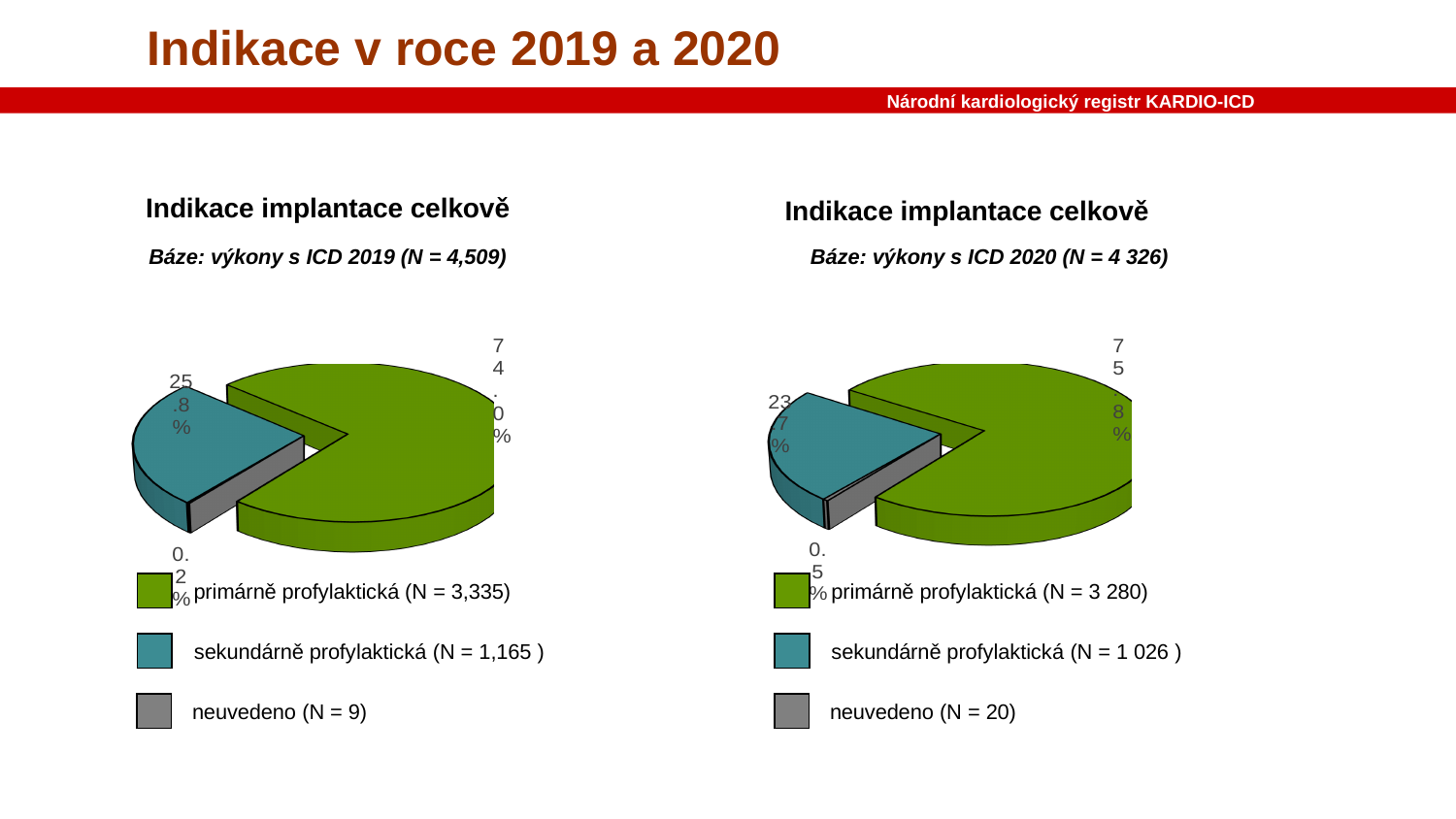
How many categories does the legend of the right chart (2020) list? 3 In the right pie chart (2020), which category has the smallest slice? neuvedeno According to the legend of the left chart (2019), what is N for sekundárně profylaktická? 1,165 In the left pie chart (2019), what share is labelled for the neuvedeno slice? 0.2% What type of chart is used on the left side of the slide? pie chart In the right pie chart (2020), what share is labelled for the sekundárně profylaktická slice? 23.7% In the left pie chart (2019), what share is labelled for the primárně profylaktická slice? 74.0% Is the primárně profylaktická share larger in the left chart (2019) or the right chart (2020)? right chart (2020) According to the legend of the right chart (2020), what is N for neuvedeno? 20 In the left pie chart (2019), which category has the largest slice? primárně profylaktická In the right pie chart (2020), what share is labelled for the primárně profylaktická slice? 75.8% What is the base (N) stated in the subtitle of the right chart? N = 4 326